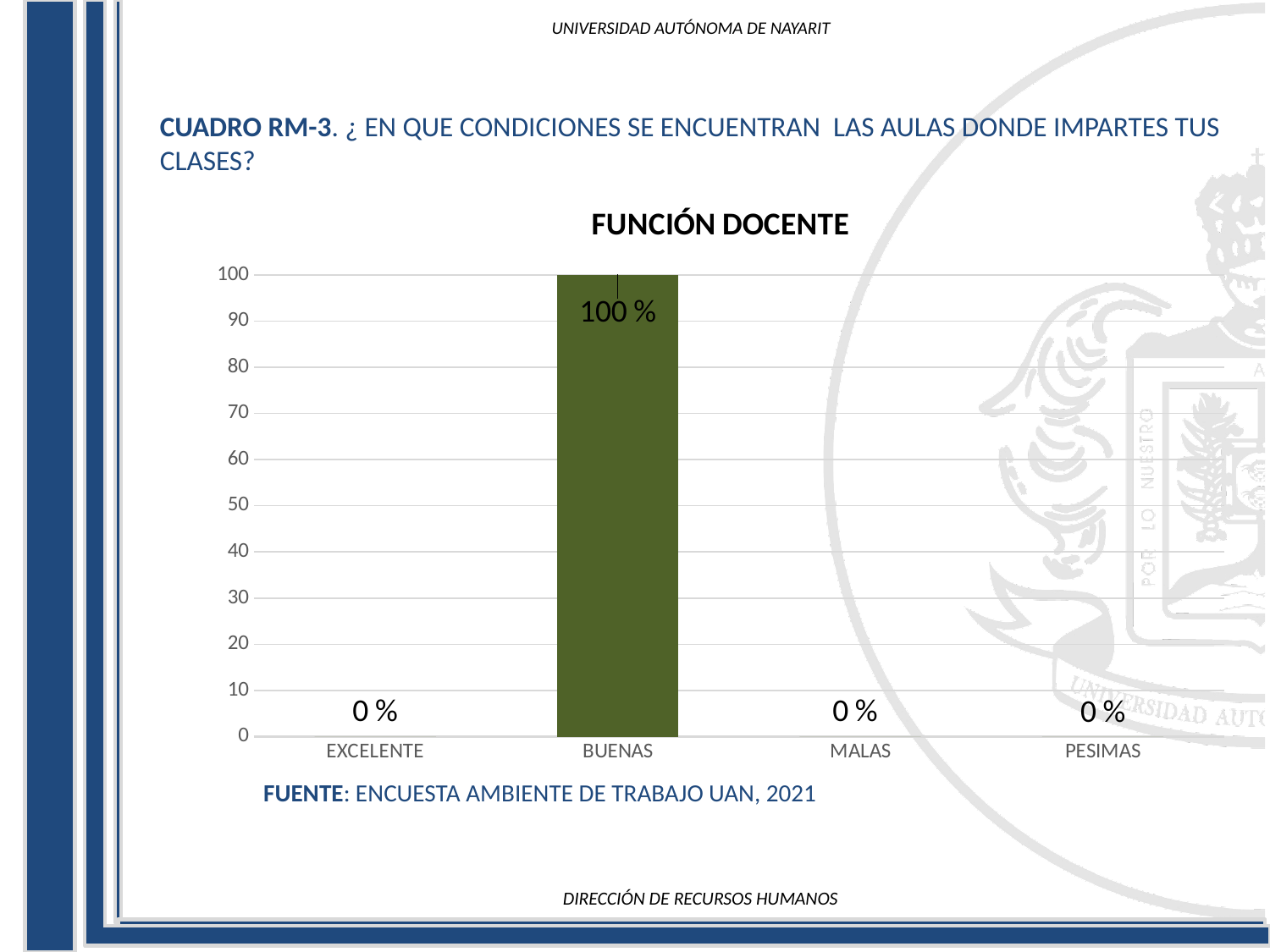
What is the value for EXCELENTE? 0 % Is the value for BUENAS greater or less than 50? greater Which category has the highest value? BUENAS What is the value for BUENAS? 100 % What is the difference between the values for BUENAS and MALAS? 100 % What is the value for PESIMAS? 0 % What is the value for MALAS? 0 % What kind of chart is shown? bar chart What is the highest value shown on the y axis? 100 Which is larger, the value for BUENAS or the value for EXCELENTE? BUENAS What is the title of the chart? FUNCIÓN DOCENTE How many categories are shown on the x axis? 4